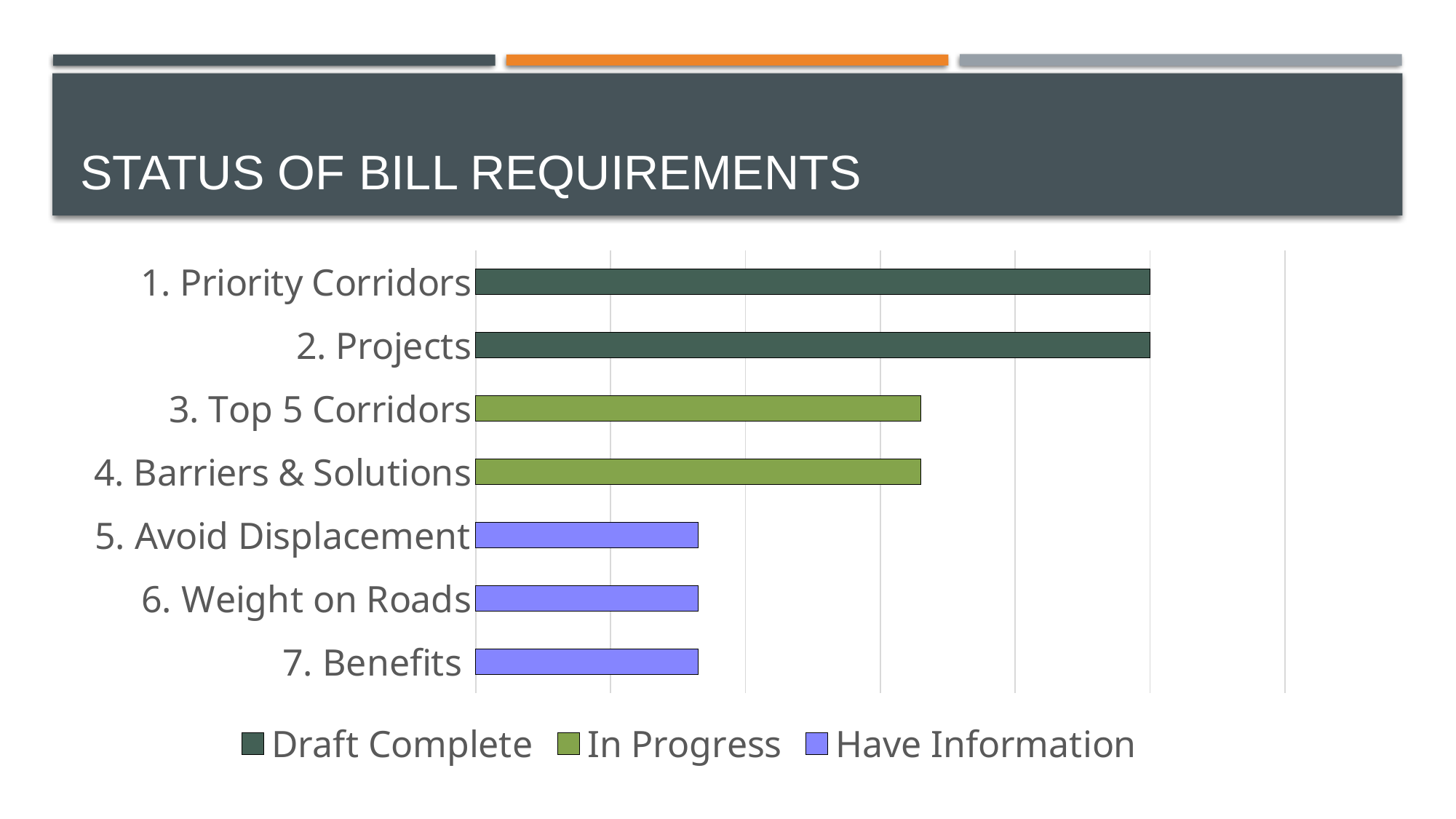
What kind of chart is shown on the slide? Bar chart How many categories are plotted on the chart? 7 What is the title of the slide containing the chart? STATUS OF BILL REQUIREMENTS Do the bar lengths increase or decrease going from category 1 at the top to category 7 at the bottom? Decrease How many series does the legend list? 3 Which is larger, the bar for 5. Avoid Displacement or the bar for 1. Priority Corridors? 1. Priority Corridors Which legend series does the bar for 3. Top 5 Corridors belong to? In Progress Which is larger, the bar for 2. Projects or the bar for 3. Top 5 Corridors? 2. Projects Which two categories have the longest bars on the chart? 1. Priority Corridors and 2. Projects Which is larger, the bar for 4. Barriers & Solutions or the bar for 7. Benefits? 4. Barriers & Solutions